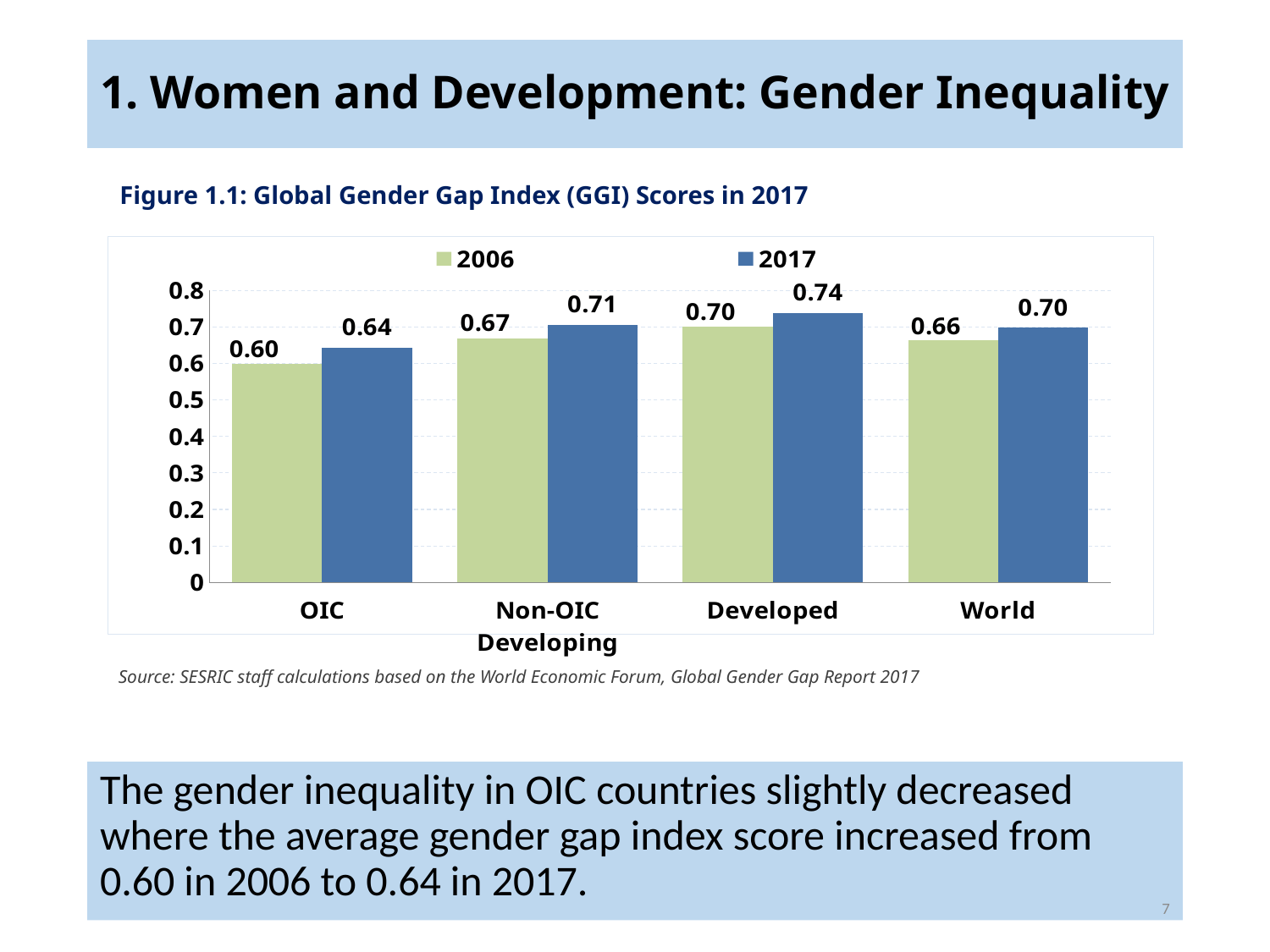
What is the 2017 GGI score for Developed? 0.74 What is the 2006 GGI score for World? 0.66 Which category has the lowest 2006 GGI score? OIC How many categories are shown on the x axis? 4 How many series does the legend list? 2 What is the 2017 GGI score for Non-OIC Developing? 0.71 What kind of chart is shown? Bar chart Which category has the highest 2017 GGI score? Developed What is the 2006 GGI score for OIC? 0.60 Which is larger, the 2017 score for World or the 2017 score for OIC? World What is the difference between the 2017 and 2006 GGI scores for OIC? 0.04 What is the title of the figure? Figure 1.1: Global Gender Gap Index (GGI) Scores in 2017